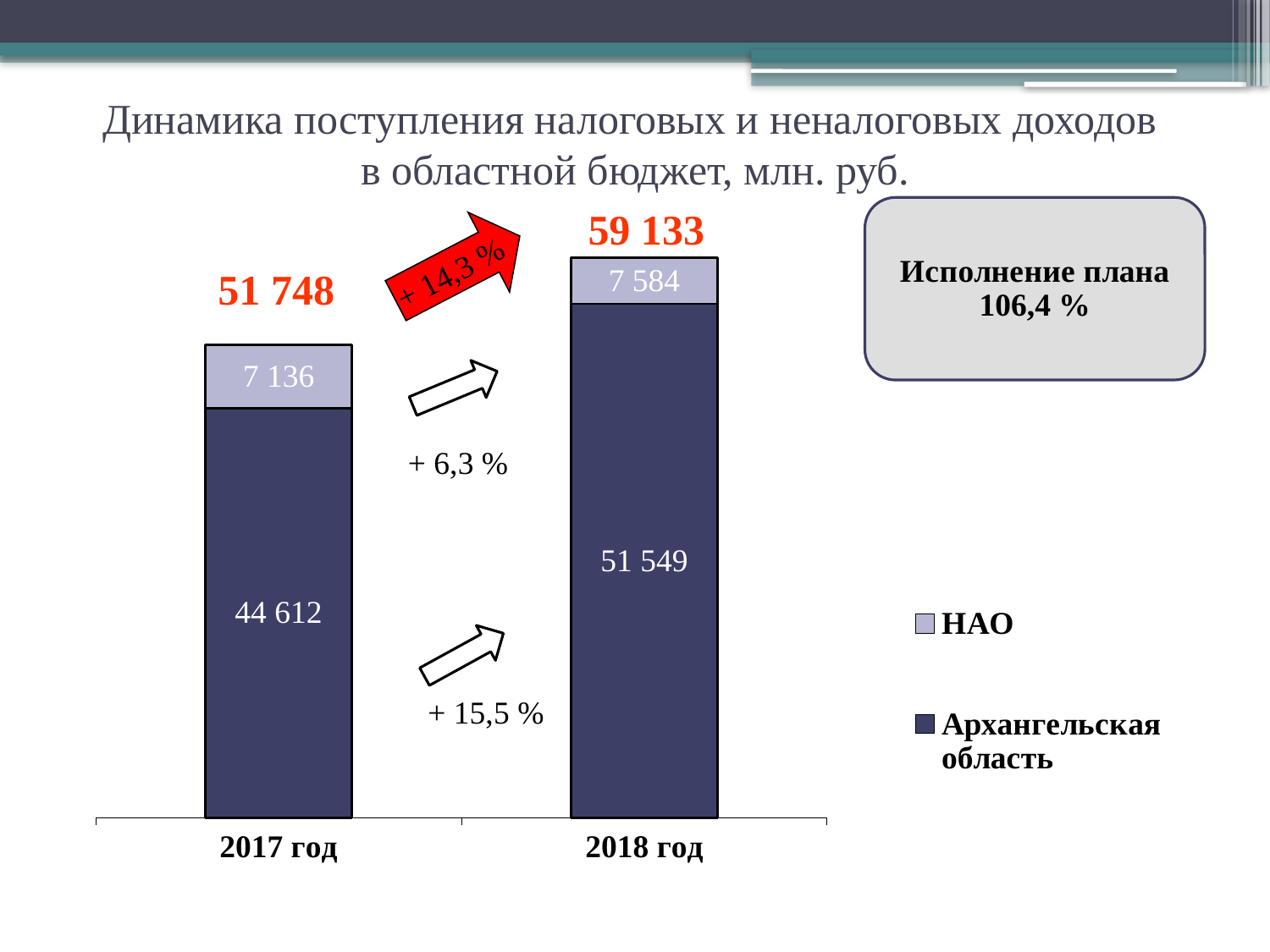
Which series is shown in the darker colour? Архангельская область What kind of chart is shown on the slide? Stacked bar chart What is the value for Архангельская область in 2018 год? 51 549 What is the value for НАО in 2017 год? 7 136 How many categories are shown on the x axis? 2 What is the difference between the Архангельская область values for 2018 год and 2017 год? 6 937 How many series does the legend list? 2 What is the total of the stacked bar for 2017 год? 51 748 What is the total of the stacked bar for 2018 год? 59 133 What is the value for Архангельская область in 2017 год? 44 612 What is the value for НАО in 2018 год? 7 584 Which year has the higher total? 2018 год